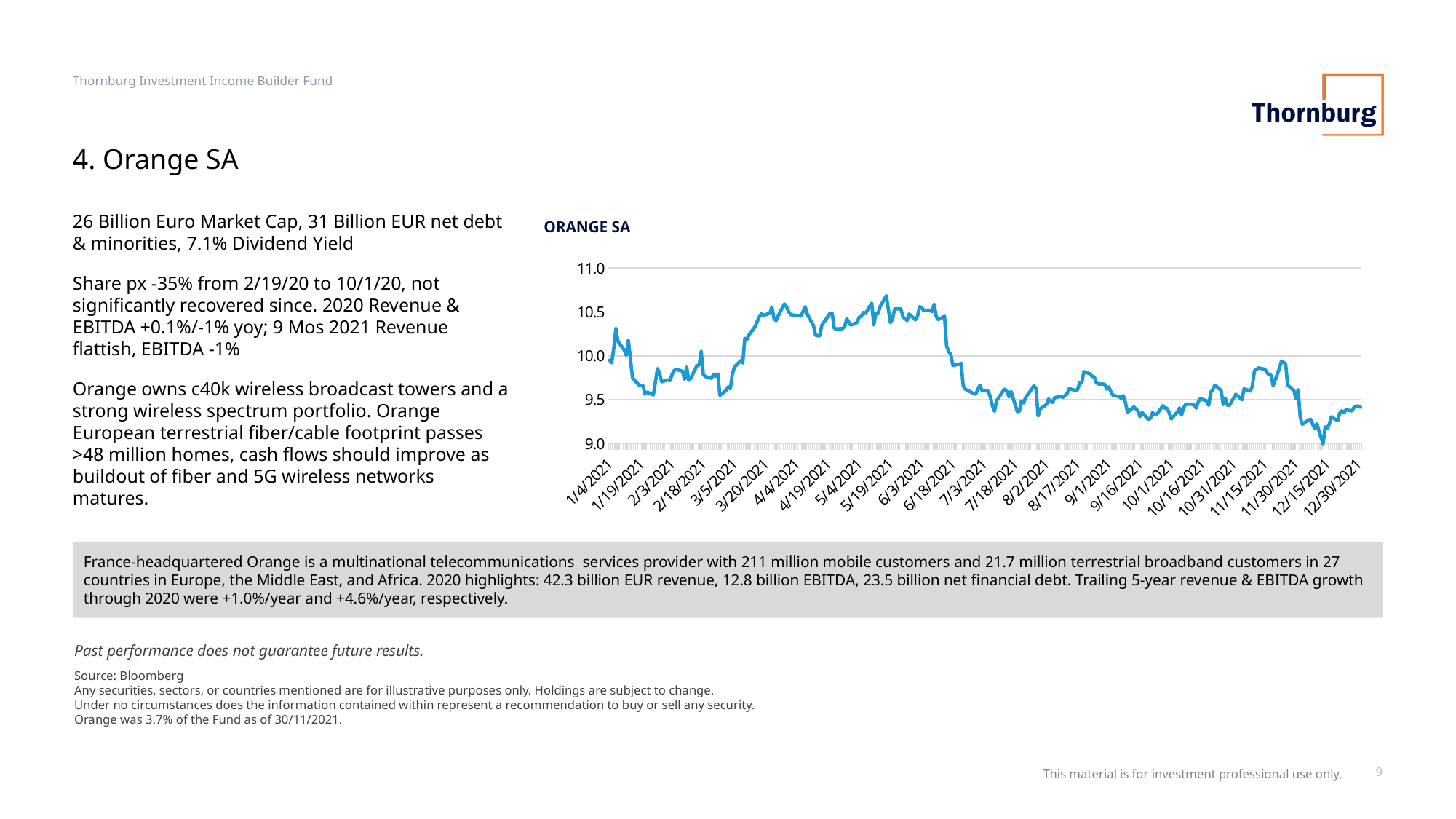
In which month does the line reach its lowest point? December 2021 Does the line rise or fall between 6/3/2021 and 6/18/2021? fall What is the title of the chart? ORANGE SA How many lines are plotted on the chart? 1 How many date labels are shown along the x axis of the chart? 25 Is the value around 2/3/2021 greater or less than 10.0? less Is the value around 7/18/2021 greater or less than 10.0? less What kind of chart is shown on the slide? line chart Does the line rise or fall between 3/5/2021 and 3/20/2021? rise Is the value around 12/15/2021 greater or less than 9.5? less What is the highest value shown on the chart's vertical axis? 11.0